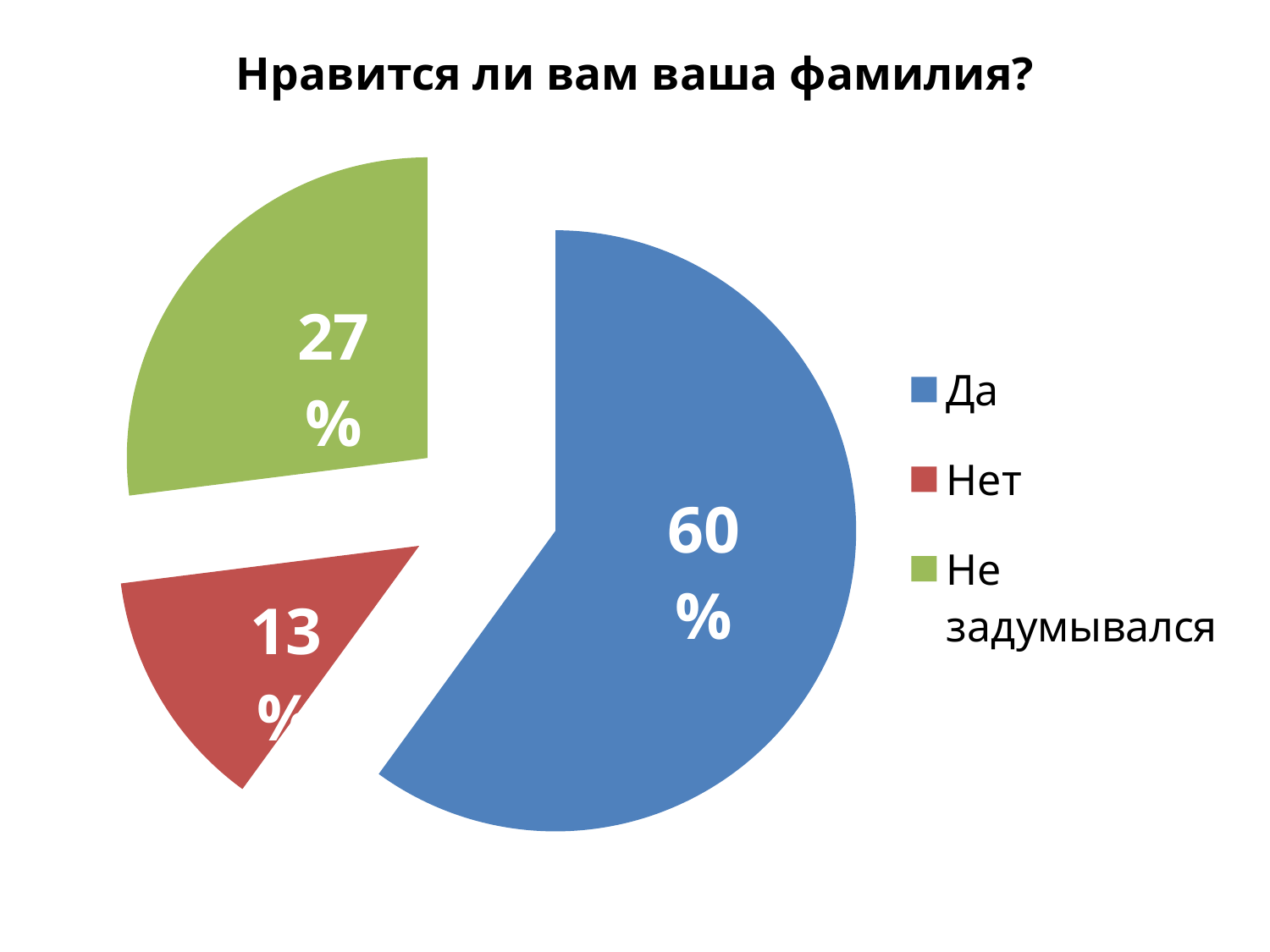
What percentage of respondents answered "Да"? 60% What type of chart is shown on the slide? pie chart How many slices does the pie chart have? 3 Which is larger, the share for "Не задумывался" or the share for "Нет"? Не задумывался What percentage of respondents answered "Не задумывался"? 27% What colour is the slice for "Не задумывался"? green Which answer has the smallest share of the pie? Нет What percentage of respondents answered "Нет"? 13% Which answer has the largest share of the pie? Да How many entries does the legend list? 3 What is the title of the chart? Нравится ли вам ваша фамилия? What is the difference in percentage points between "Да" and "Нет"? 47